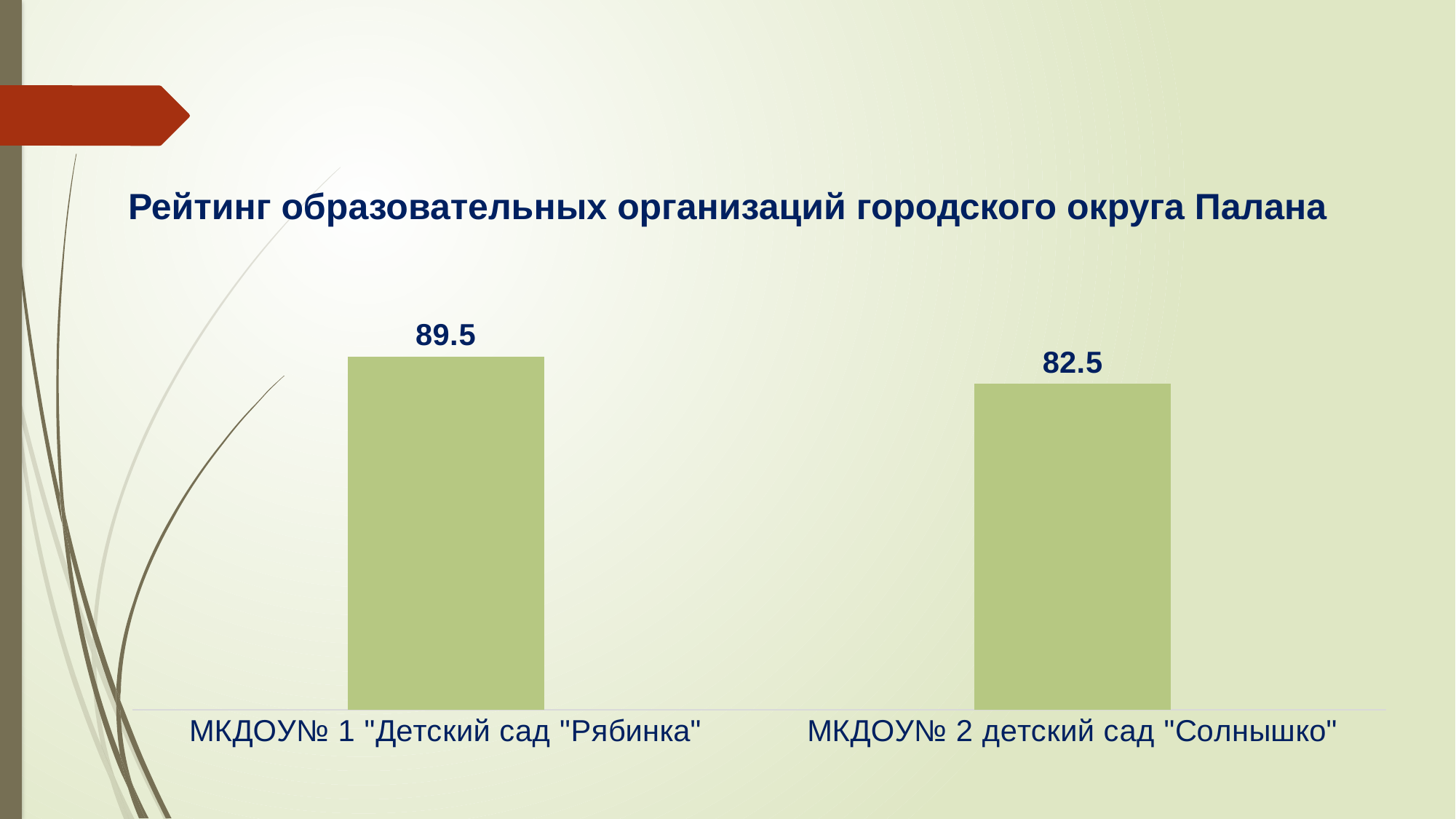
What kind of chart is shown on the slide? Bar chart Which category has the highest value? МКДОУ№ 1 "Детский сад "Рябинка" What is the difference between the values for МКДОУ№ 1 "Детский сад "Рябинка" and МКДОУ№ 2 детский сад "Солнышко"? 7 What is the title of the slide? Рейтинг образовательных организаций городского округа Палана What is the value for МКДОУ№ 1 "Детский сад "Рябинка"? 89.5 Which category has the lowest value? МКДОУ№ 2 детский сад "Солнышко" What colour are the bars in the chart? Light green What is the value for МКДОУ№ 2 детский сад "Солнышко"? 82.5 Which is larger: the value for МКДОУ№ 1 "Детский сад "Рябинка" or for МКДОУ№ 2 детский сад "Солнышко"? МКДОУ№ 1 "Детский сад "Рябинка" Do the values rise or fall from left to right across the categories? Fall How many categories are shown in the chart? 2